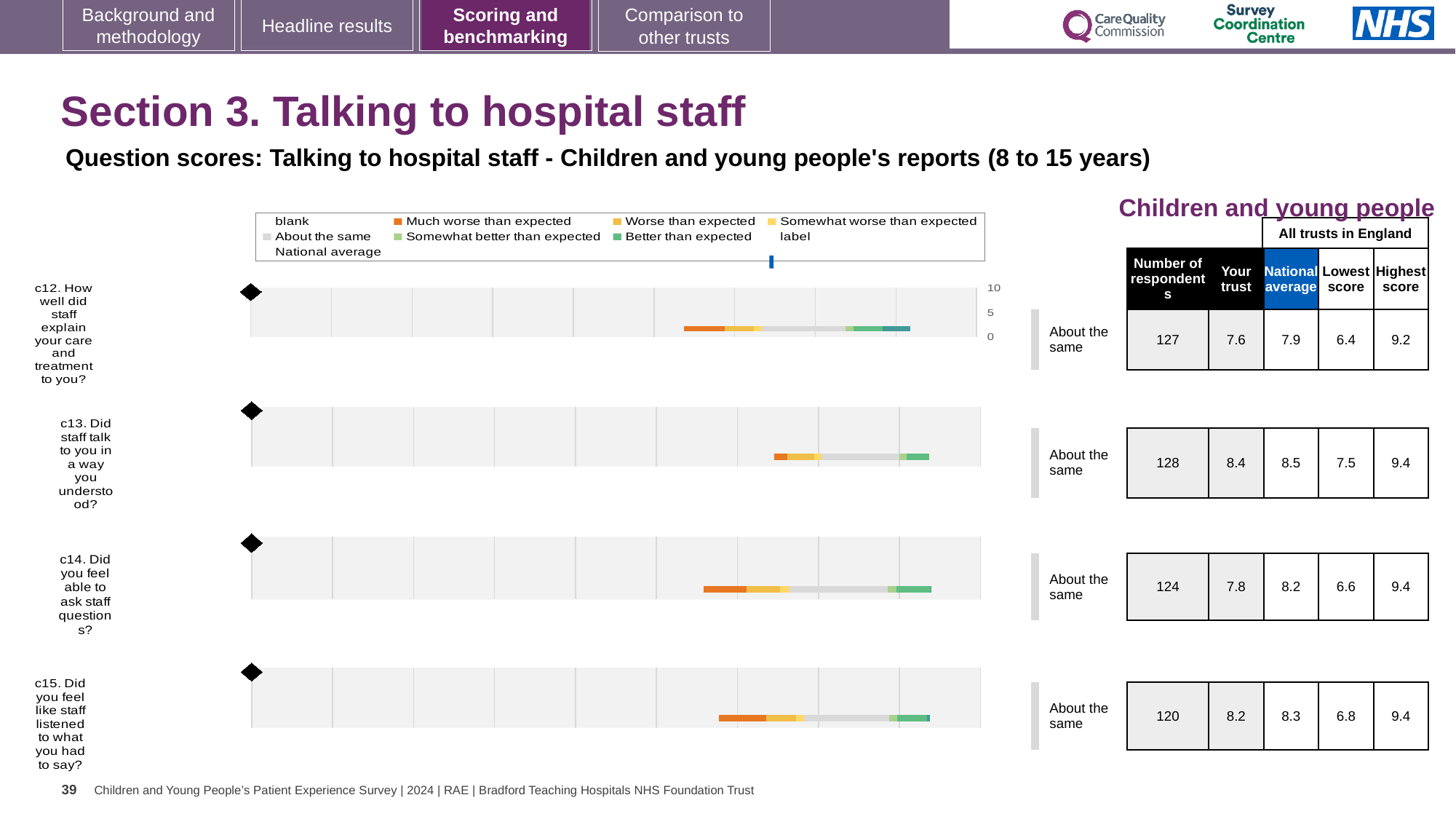
For c14, what is the difference between the national average and the 'Your trust' score? 0.4 What benchmark category is shown next to the c12 chart? About the same What kind of chart is used for each question row (c12 to c15)? bar chart For c13 (Did staff talk to you in a way you understood?), what is the national average score? 8.5 Which question has the highest 'Your trust' score? c13. Did staff talk to you in a way you understood? For c12 (How well did staff explain your care and treatment to you?), what is the 'Your trust' score? 7.6 For c14 (Did you feel able to ask staff questions?), how many respondents are there? 124 Is the 'Your trust' score for c12 greater or less than 5 on the chart axis? greater Which has the larger 'Your trust' score, c13 or c15? c13 Which question has the lowest 'Your trust' score? c12. How well did staff explain your care and treatment to you? How many survey questions (rows) are plotted in the benchmarking charts on this slide? 4 For c15 (Did you feel like staff listened to what you had to say?), what is the highest score among all trusts in England? 9.4